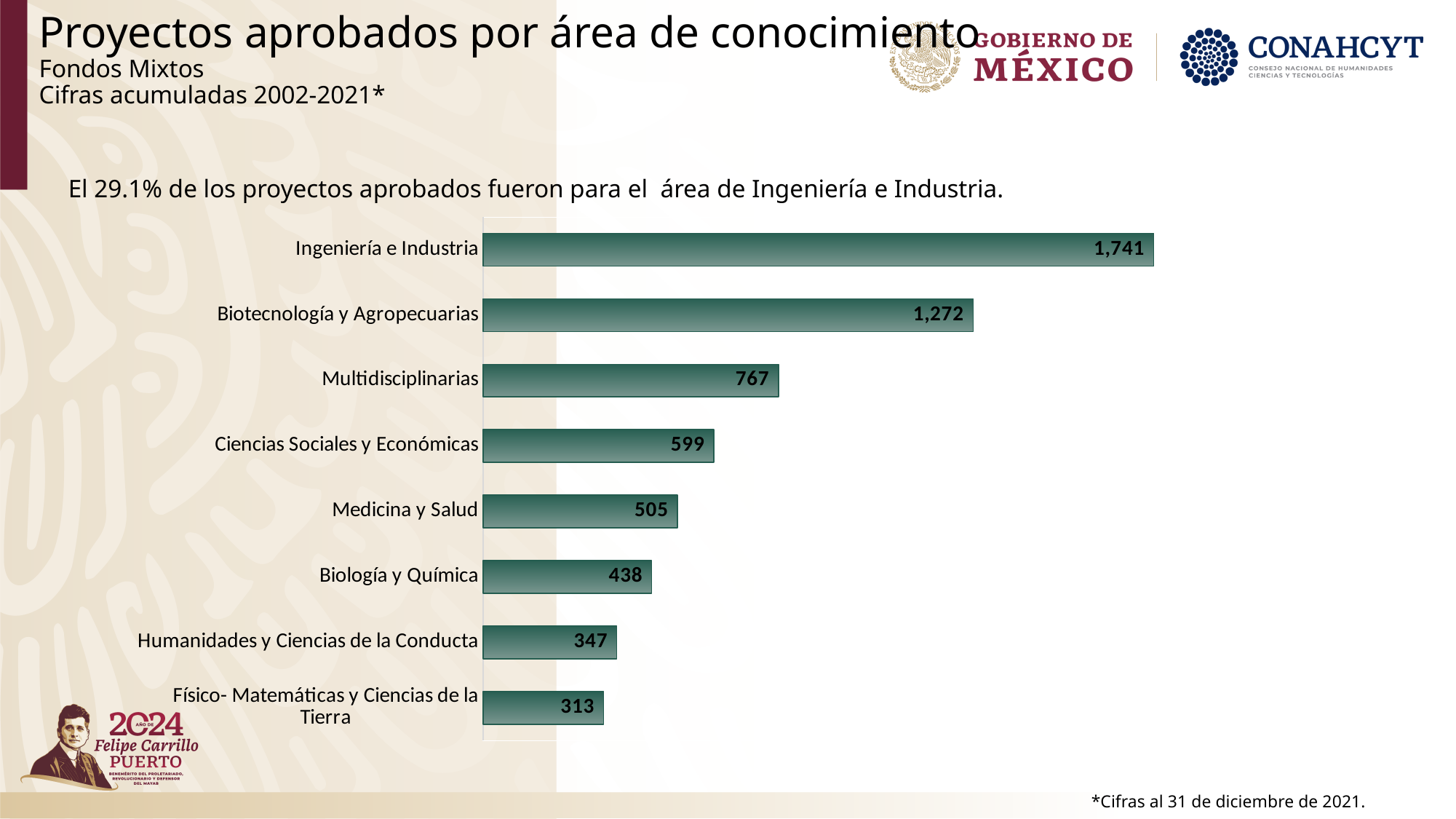
Which is larger, Biología y Química or Humanidades y Ciencias de la Conducta? Biología y Química Which area has the lowest number of approved projects? Físico- Matemáticas y Ciencias de la Tierra How many areas of knowledge are shown in the chart? 8 What is the difference between Multidisciplinarias and Ciencias Sociales y Económicas? 168 What is the value for Biotecnología y Agropecuarias? 1,272 What is the difference between Ingeniería e Industria and Biotecnología y Agropecuarias? 469 Which area has the highest number of approved projects? Ingeniería e Industria What is the value for Físico- Matemáticas y Ciencias de la Tierra? 313 What is the value for Ingeniería e Industria? 1,741 What kind of chart is shown on the slide? Bar chart What is the title of the slide? Proyectos aprobados por área de conocimiento What is the value for Medicina y Salud? 505